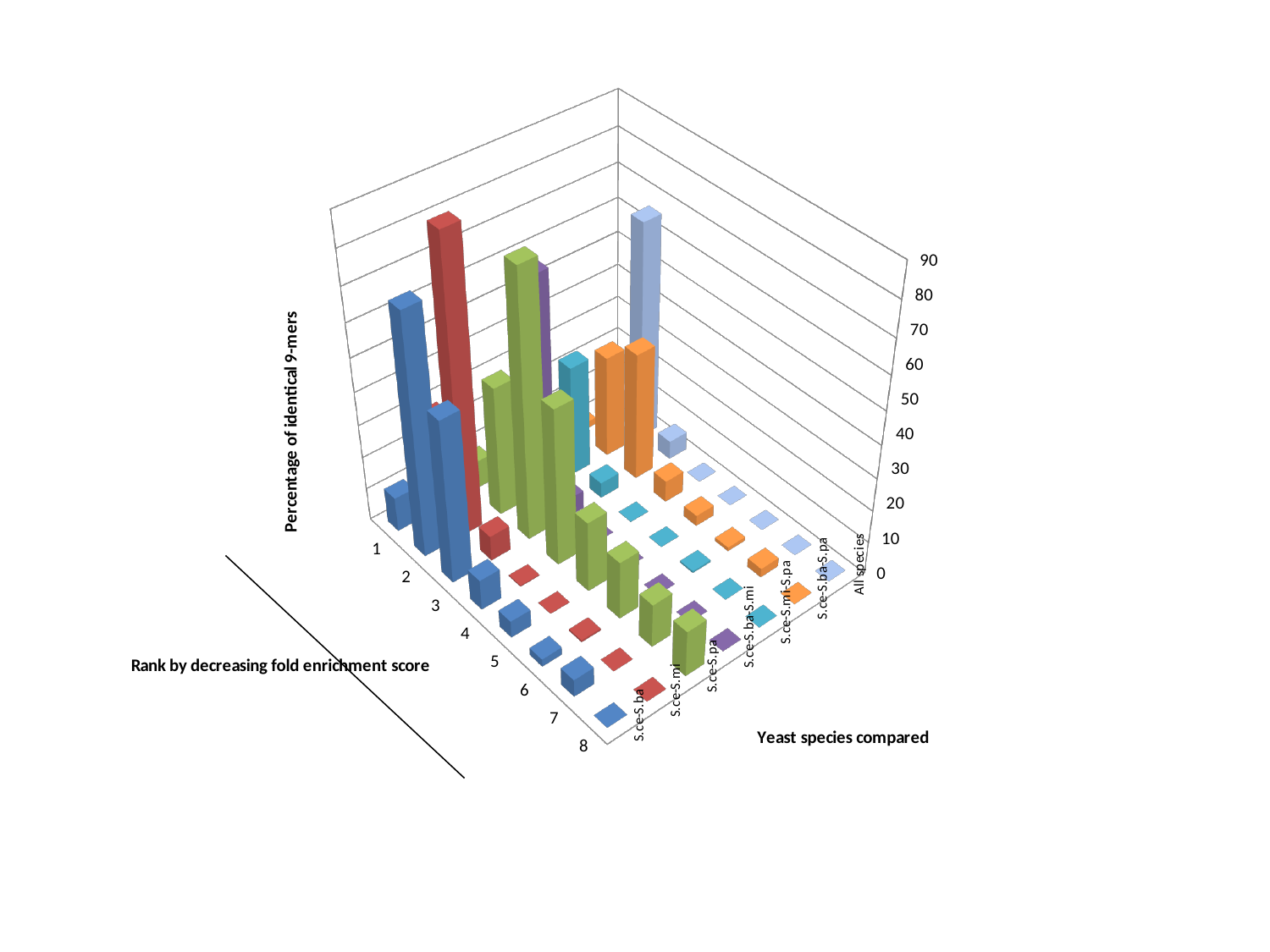
For S.ce-S.ba, is the bar at rank 1 larger or smaller than the bar at rank 8? larger Among the S.ce-S.pa bars, which rank has the tallest bar? 3 Among the S.ce-S.ba bars, which rank has the tallest bar? 2 What is the highest tick value shown on the vertical axis? 90 Is the value for S.ce-S.ba at rank 8 greater or less than 10? less What is the title of the vertical axis? Percentage of identical 9-mers How many rank categories are shown along the 'Rank by decreasing fold enrichment score' axis? 8 What kind of chart is shown on the slide? 3D bar chart How many yeast species comparisons are listed along the 'Yeast species compared' axis? 7 Among the S.ce-S.mi bars, which rank has the tallest bar? 2 For S.ce-S.mi, do the bar heights generally rise or fall as the rank increases from 1 to 8? fall Is the value for S.ce-S.mi at rank 8 greater or less than 10? less